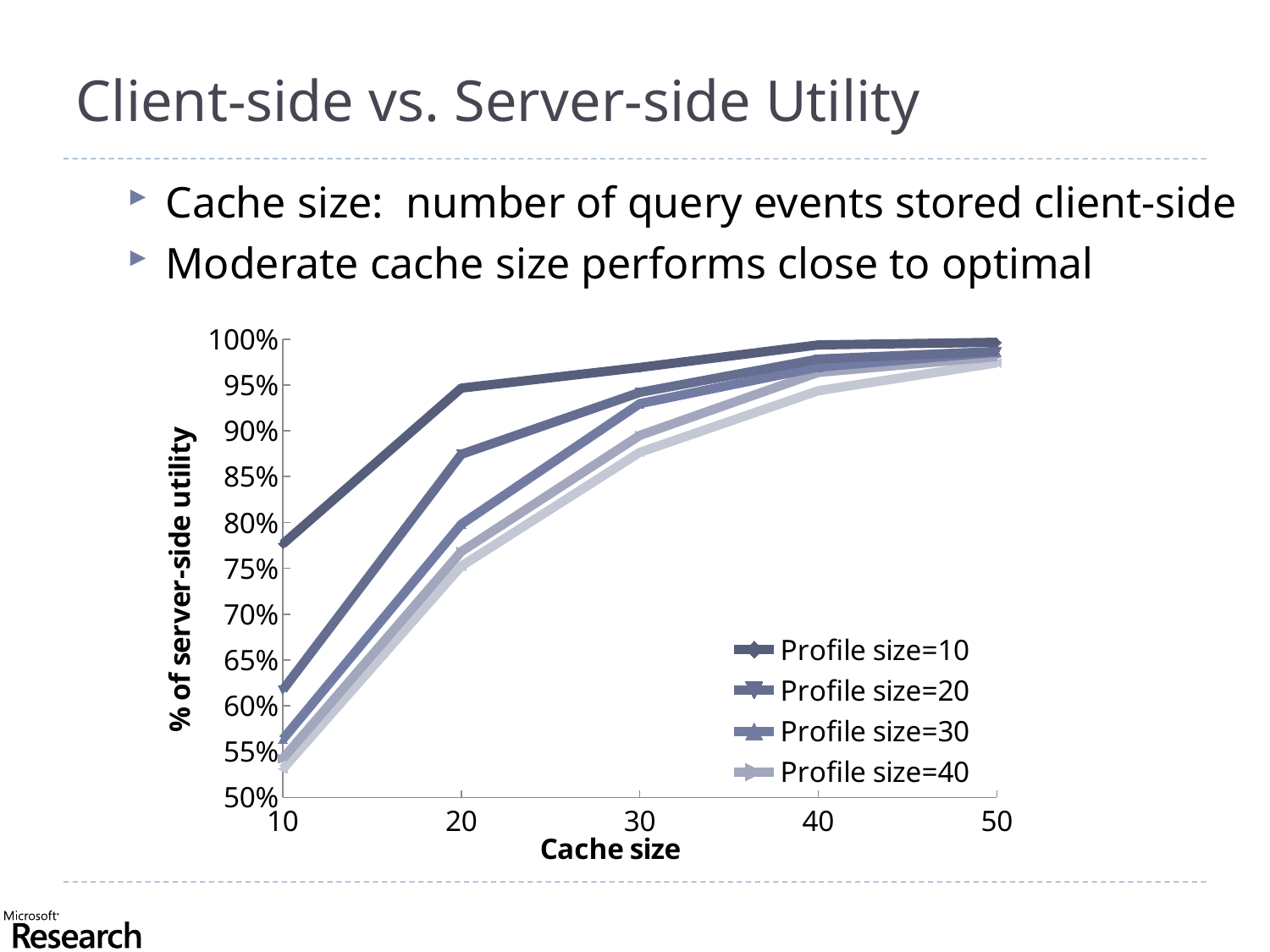
What is the title of the y axis? % of server-side utility Do the values for Profile size=10 rise or fall as cache size increases? rise How many series does the legend list? 4 Is the value for Profile size=20 at cache size 20 greater or less than 85%? greater Which series has the highest value at cache size 10? Profile size=10 Is the value for Profile size=10 at cache size 10 greater or less than 75%? greater How many cache size values are plotted along the x axis? 5 What kind of chart is shown on the slide? line chart Is the value for Profile size=30 at cache size 30 greater or less than 90%? greater At cache size 10, which is larger: the value for Profile size=10 or Profile size=40? Profile size=10